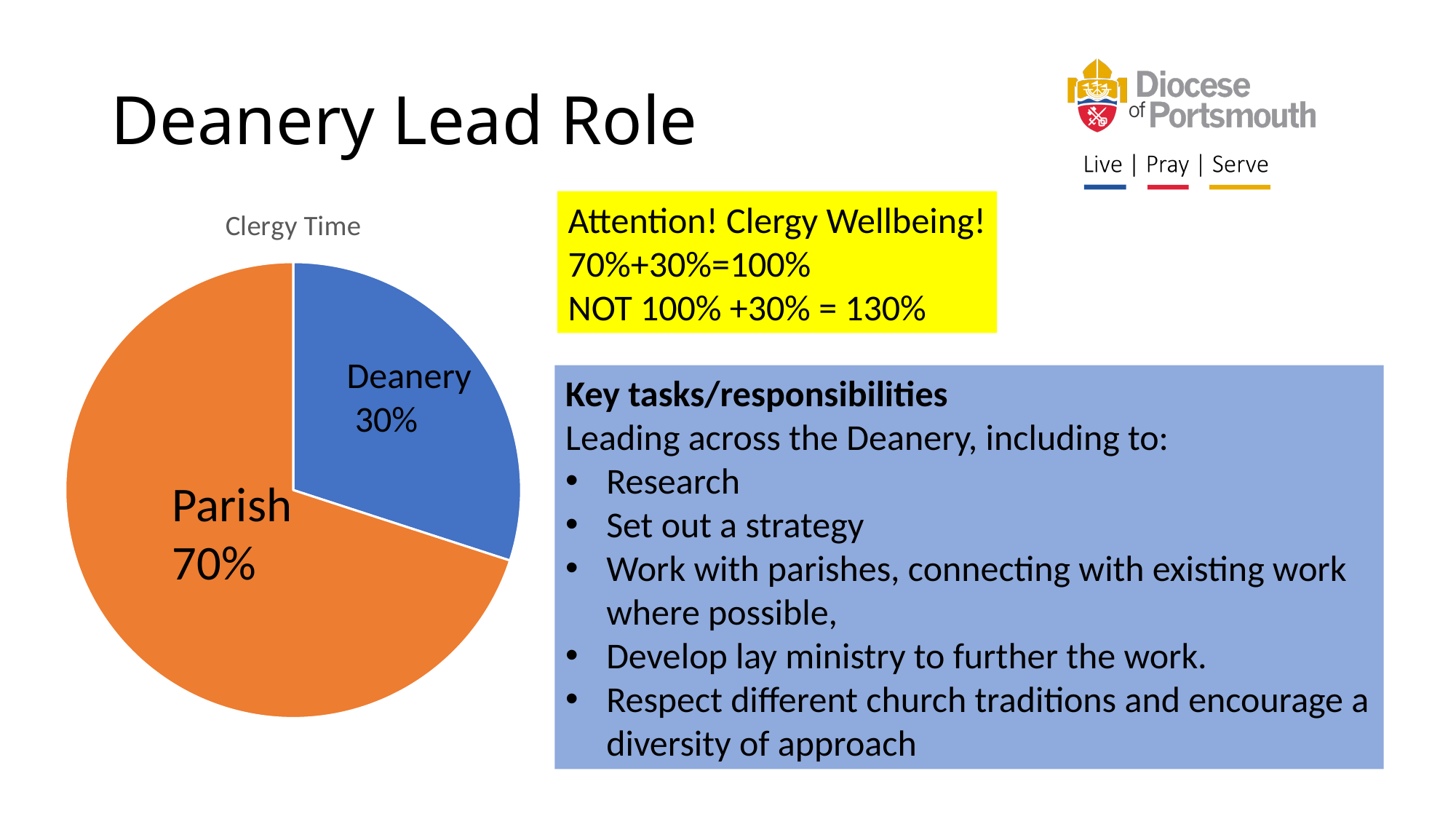
What is the total of the Parish and Deanery shares? 100% Which slice of the pie is the smallest? Deanery What share of clergy time does the Deanery slice represent? 30% What type of chart is shown on the slide? pie chart What colour is the Parish slice? orange How many slices does the pie chart have? 2 Which slice of the pie is the largest? Parish What is the title of the chart? Clergy Time What is the difference between the Parish share and the Deanery share? 40% Which is larger, the Parish share or the Deanery share? Parish What share of clergy time does the Parish slice represent? 70%